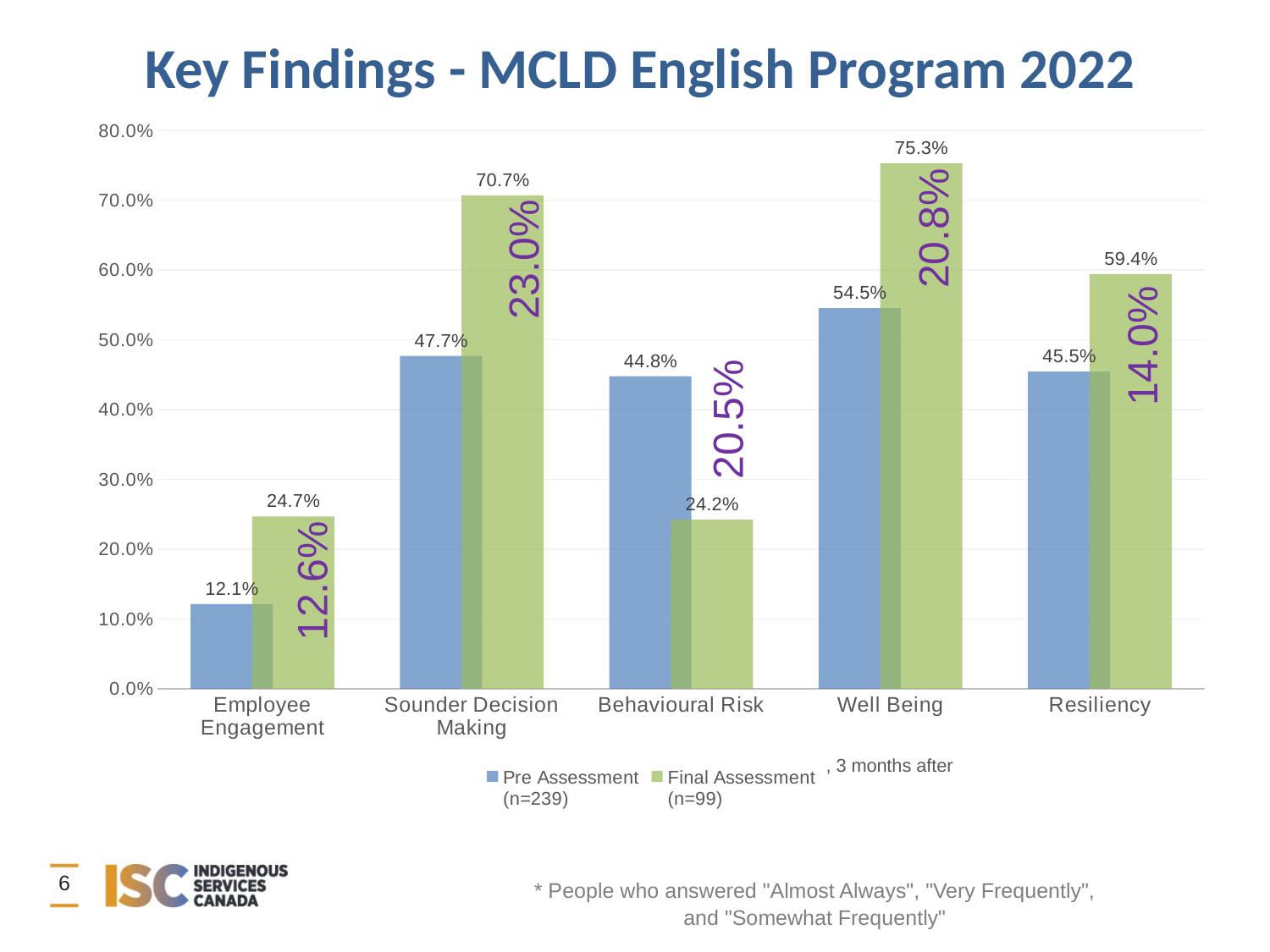
What kind of chart is shown on the slide? Bar chart How many categories are shown on the x axis? 5 Which category has the lowest Pre Assessment value? Employee Engagement What is the Pre Assessment value for Employee Engagement? 12.1% How many series does the legend list? 2 What is the Final Assessment value for Well Being? 75.3% What is the Final Assessment value for Behavioural Risk? 24.2% Which category has the highest Final Assessment value? Well Being What is the difference between the Pre Assessment and Final Assessment values for Behavioural Risk? 20.6% Which is larger for Behavioural Risk, the Pre Assessment value or the Final Assessment value? Pre Assessment What is the difference between the Final Assessment and Pre Assessment values for Sounder Decision Making? 23.0% Which is larger for Resiliency, the Pre Assessment value or the Final Assessment value? Final Assessment